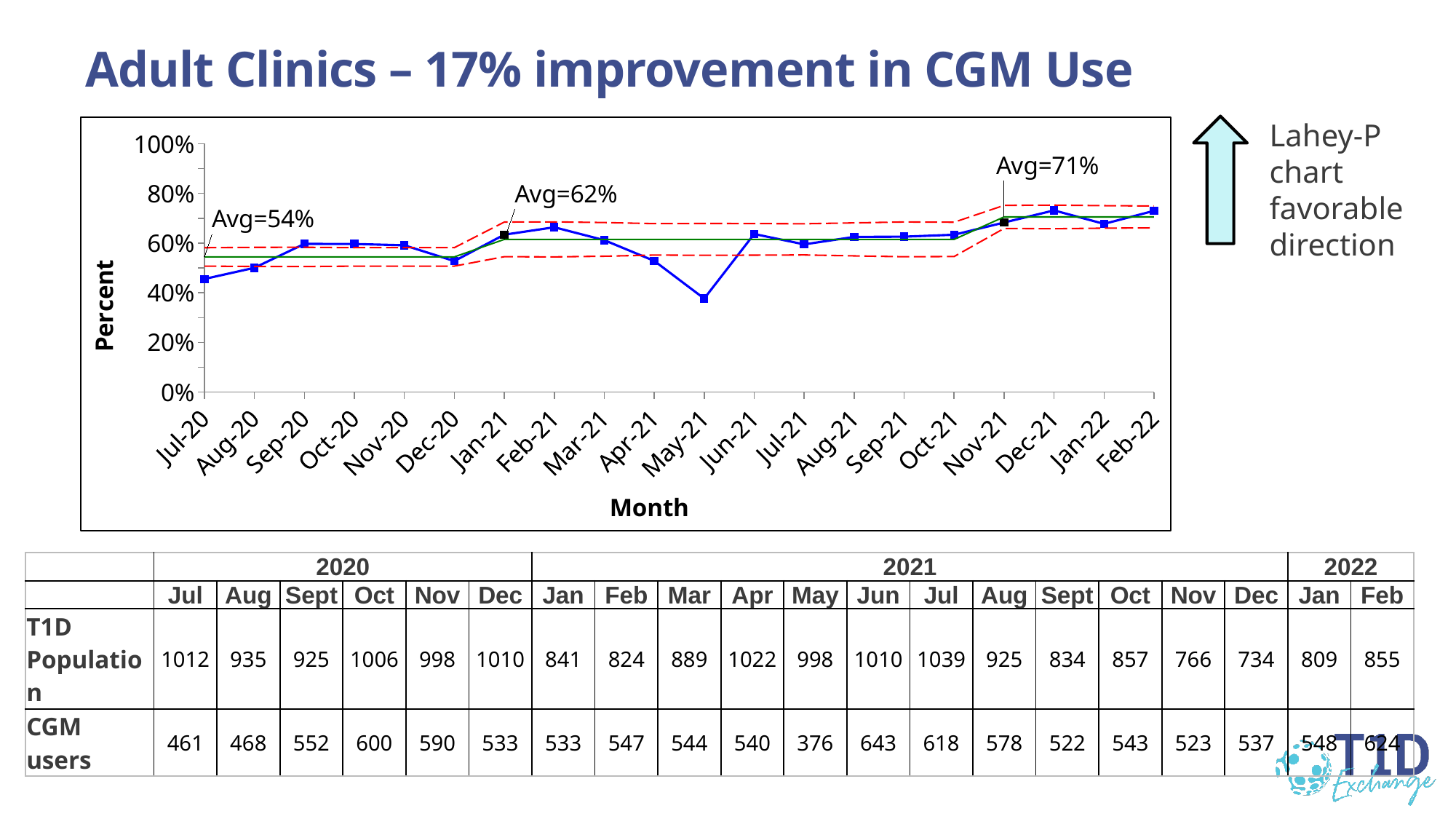
Which is larger, the value for Feb-21 or the value for Apr-21? Feb-21 What is the label of the y axis? Percent What is the average value annotated for the phase starting Nov-21? Avg=71% Is the value for May-21 greater or less than 40%? less What is the average value annotated for the first phase of the chart (starting Jul-20)? Avg=54% Is the value for Dec-21 greater or less than 60%? greater Is the value for Jul-20 greater or less than 60%? less What kind of chart is shown on the slide? line chart Which month has the lowest CGM use percentage on the chart? May-21 Do the values generally rise or fall from Jul-20 to Feb-22? rise What is the average value annotated for the phase starting Jan-21? Avg=62% How many monthly data points are plotted on the chart? 20